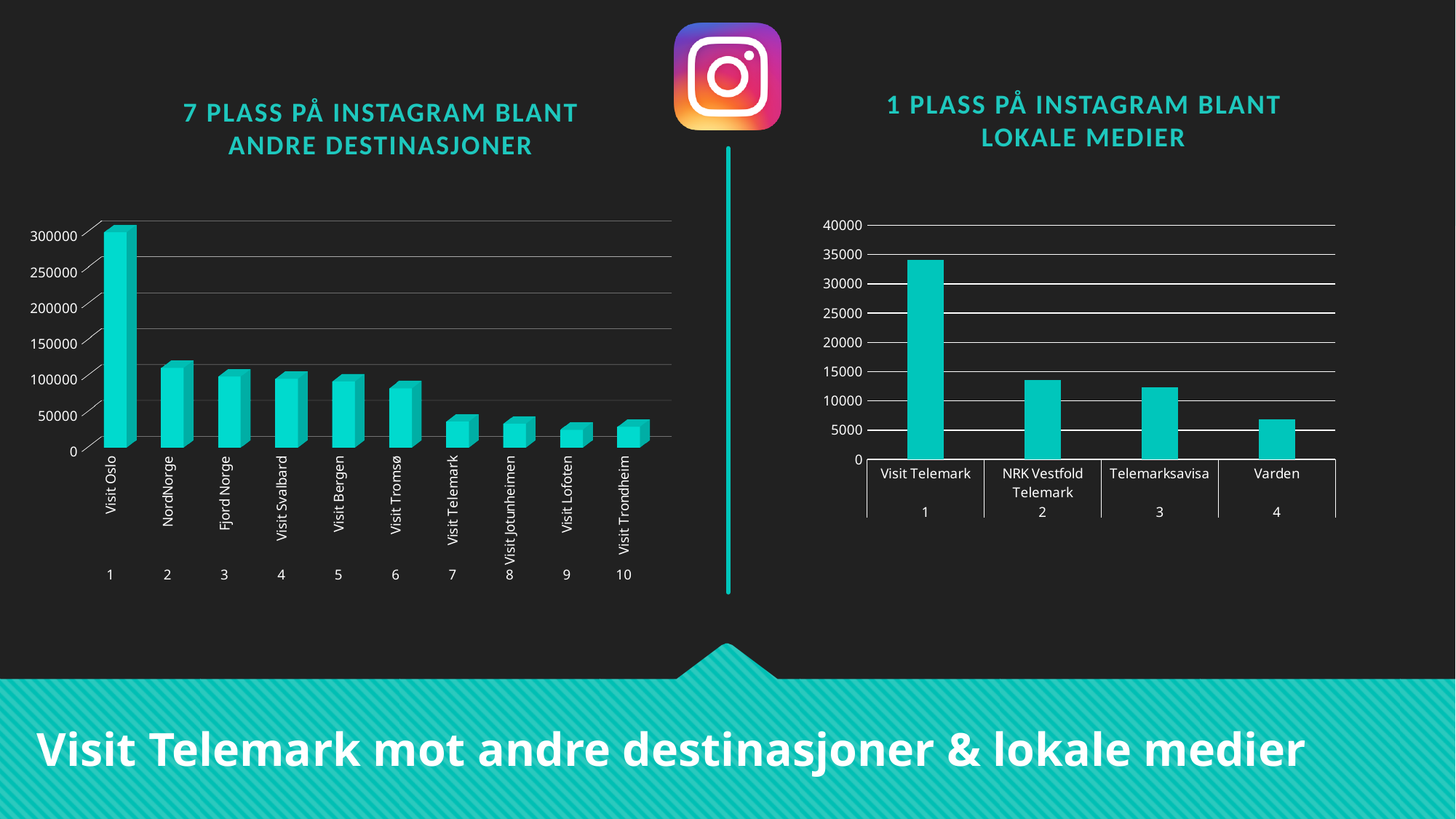
In the left chart titled '7 PLASS PÅ INSTAGRAM BLANT ANDRE DESTINASJONER', is the value for Visit Telemark greater or less than 50000? less In the left chart titled '7 PLASS PÅ INSTAGRAM BLANT ANDRE DESTINASJONER', what rank number is shown under Visit Telemark? 7 What kind of chart is the right chart titled '1 PLASS PÅ INSTAGRAM BLANT LOKALE MEDIER'? Bar chart How many categories are shown in the right chart titled '1 PLASS PÅ INSTAGRAM BLANT LOKALE MEDIER'? 4 In the left chart titled '7 PLASS PÅ INSTAGRAM BLANT ANDRE DESTINASJONER', which category has the highest value? Visit Oslo In the right chart titled '1 PLASS PÅ INSTAGRAM BLANT LOKALE MEDIER', do the values rise or fall from left to right? Fall In the left chart titled '7 PLASS PÅ INSTAGRAM BLANT ANDRE DESTINASJONER', is the value for Visit Oslo greater or less than 250000? greater How many categories are shown in the left chart titled '7 PLASS PÅ INSTAGRAM BLANT ANDRE DESTINASJONER'? 10 In the right chart titled '1 PLASS PÅ INSTAGRAM BLANT LOKALE MEDIER', which category has the lowest value? Varden In the left chart titled '7 PLASS PÅ INSTAGRAM BLANT ANDRE DESTINASJONER', which is larger, the value for NordNorge or the value for Visit Telemark? NordNorge What kind of chart is the left chart titled '7 PLASS PÅ INSTAGRAM BLANT ANDRE DESTINASJONER'? Bar chart In the right chart titled '1 PLASS PÅ INSTAGRAM BLANT LOKALE MEDIER', is the value for Visit Telemark greater or less than 30000? greater